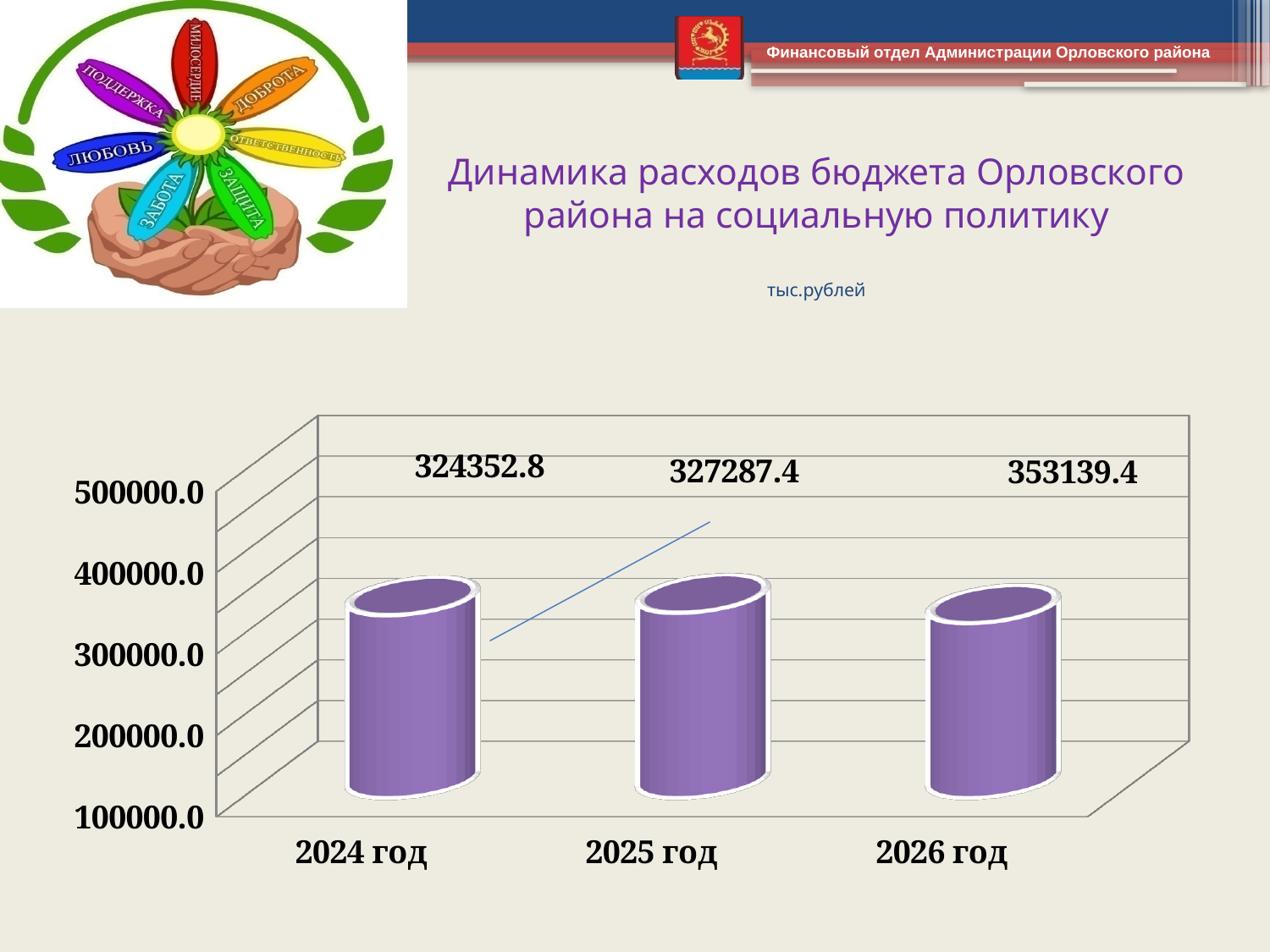
What is the value for 2024 год? 324352.8 What is the value for 2025 год? 327287.4 Which is larger, the value for 2025 год or the value for 2024 год? 2025 год What is the value for 2026 год? 353139.4 Is the value for 2026 год greater or less than 400000.0? less What is the difference between the values for 2026 год and 2025 год? 25852.0 What is the difference between the values for 2026 год and 2024 год? 28786.6 What kind of chart is shown on the slide? bar chart How many years are shown on the chart? 3